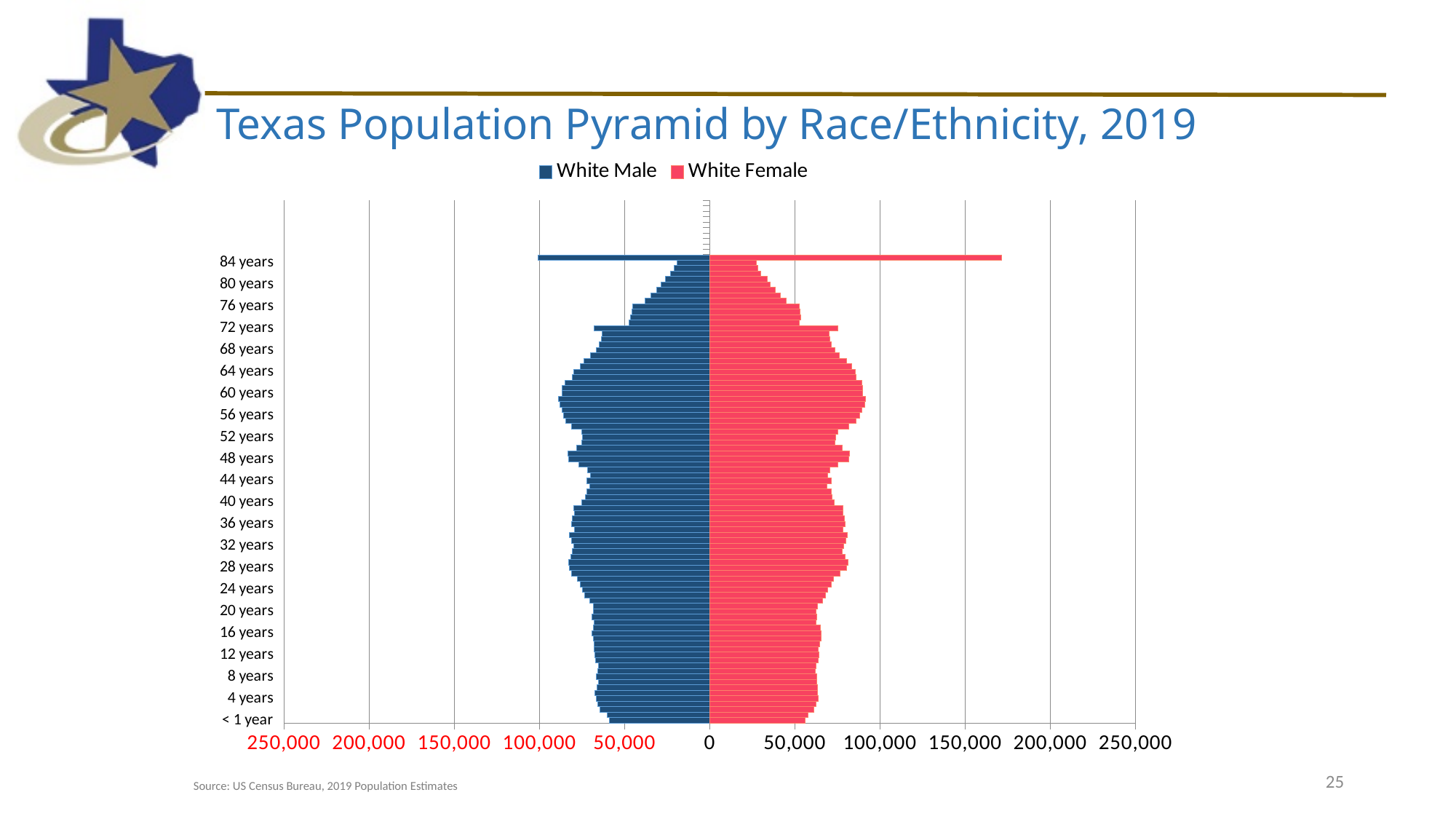
Is the White Female value for 60 years greater or less than 50,000? greater What are the two series named in the legend? White Male and White Female Is the White Male value for 4 years greater or less than 100,000? less Is the White Male value for 84 years greater or less than 50,000? less What kind of chart is shown on the slide? Bar chart What is the title of the chart? Texas Population Pyramid by Race/Ethnicity, 2019 How many series does the legend list? 2 At 84 years, which series has the larger value, White Male or White Female? White Female